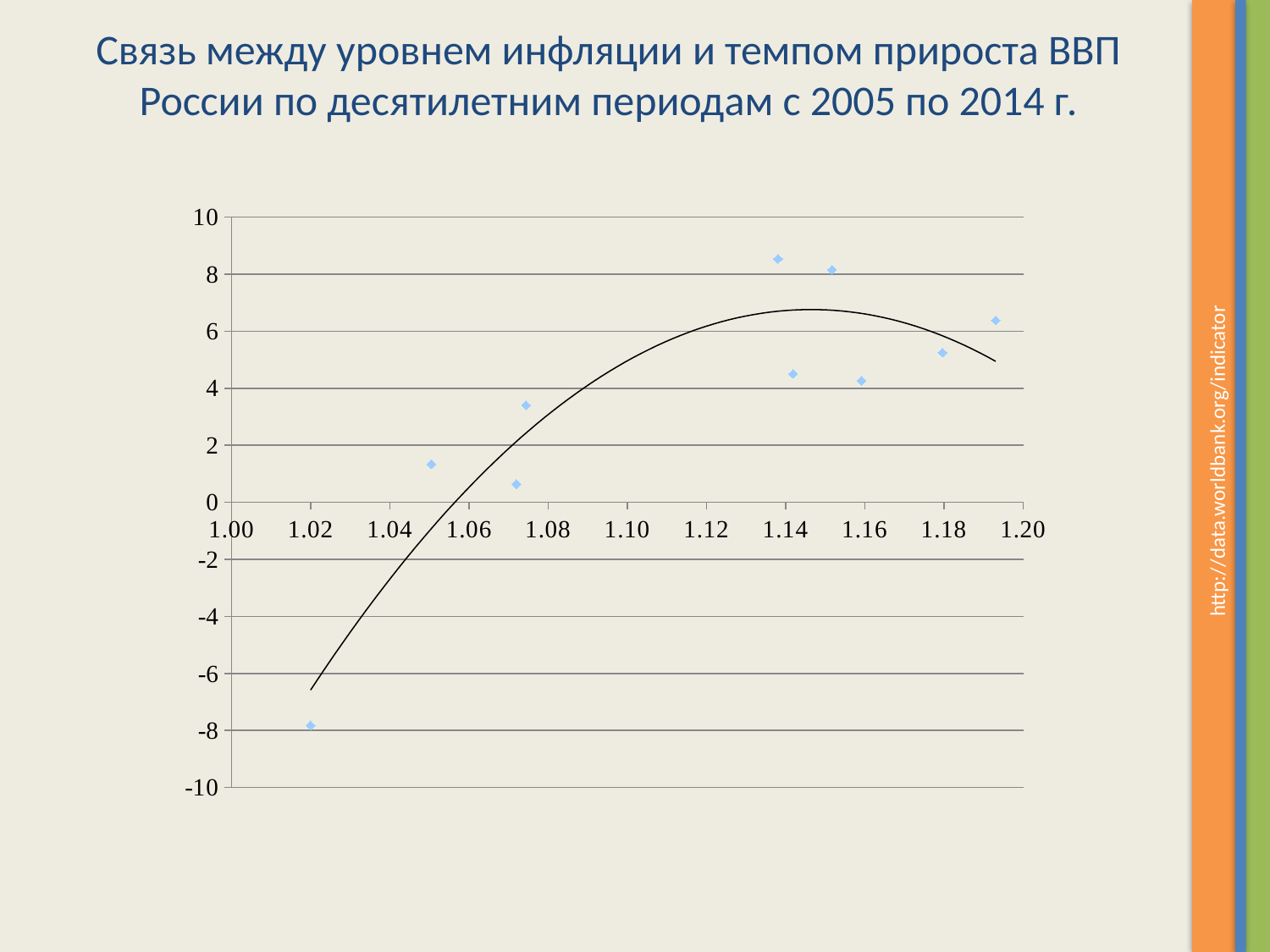
Is the value of the data point at about 1.02 on the horizontal axis greater or less than -6? less Does the fitted curve rise or fall as the horizontal axis goes from 1.02 to 1.10? rises Is the value of the data point at about 1.16 on the horizontal axis greater or less than 6? less What range does the horizontal axis cover? 1.00 to 1.20 Which data point has the lowest value on the vertical axis: the one at about 1.02 or the one at about 1.18? the one at about 1.02 Is the value of the data point at about 1.19 on the horizontal axis greater or less than 4? greater How many data points lie above 8 on the vertical axis? 2 How many data points are plotted on the chart? 10 What kind of chart is shown on the slide? scatter chart What is the highest value shown on the vertical axis? 10 How many data points lie below zero on the vertical axis? 1